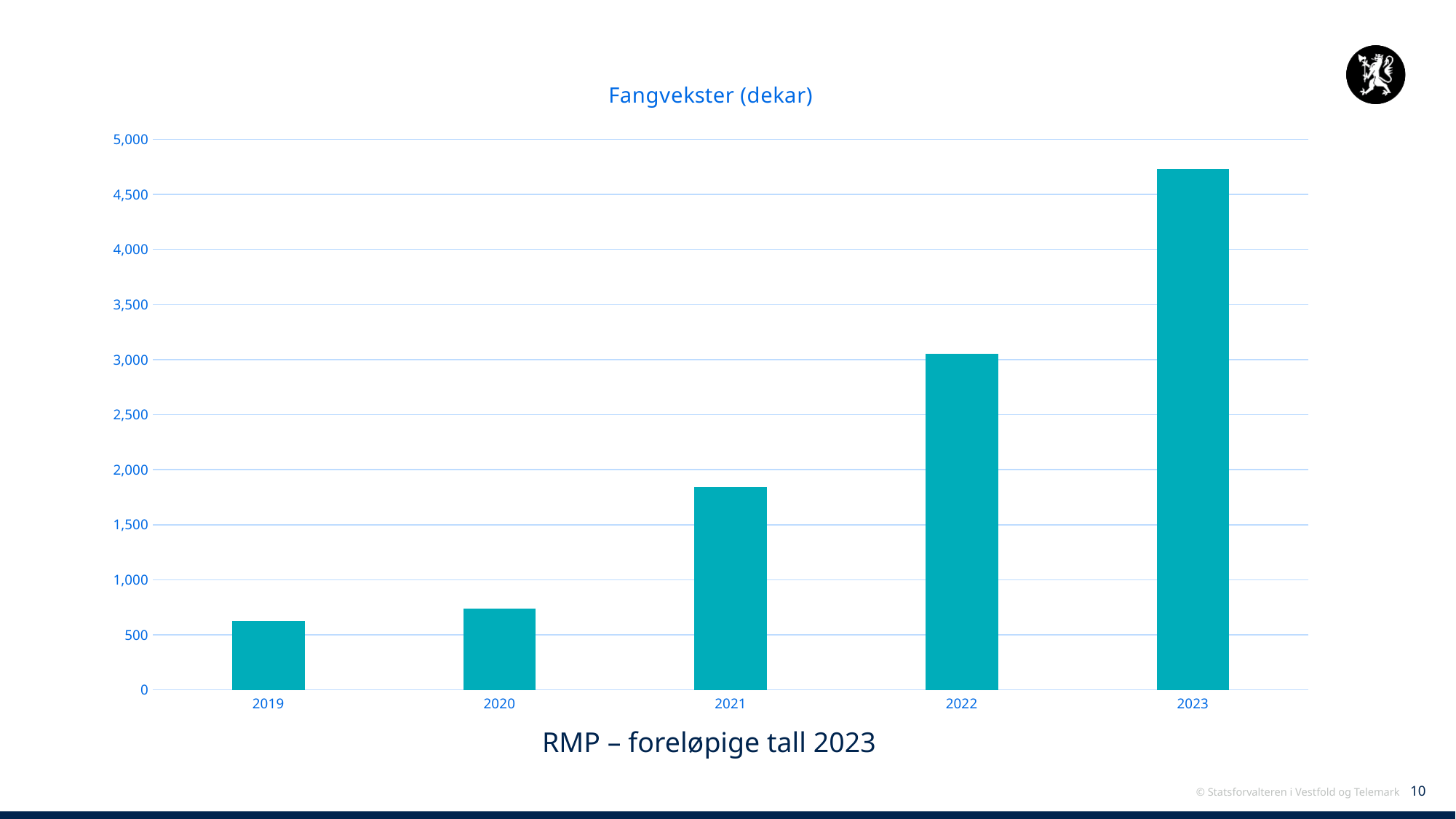
Which year has the lowest value in the chart? 2019 Is the value for 2022 greater or less than 2,500? greater Is the value for 2021 greater or less than 2,000? less Which year has the larger value, 2021 or 2022? 2022 Is the value for 2023 greater or less than 4,500? greater What kind of chart is shown on the slide? Bar chart Do the values rise or fall from 2019 to 2023? Rise How many years are shown on the x axis of the chart? 5 What is the title of the chart? Fangvekster (dekar) Which year has the highest value in the chart? 2023